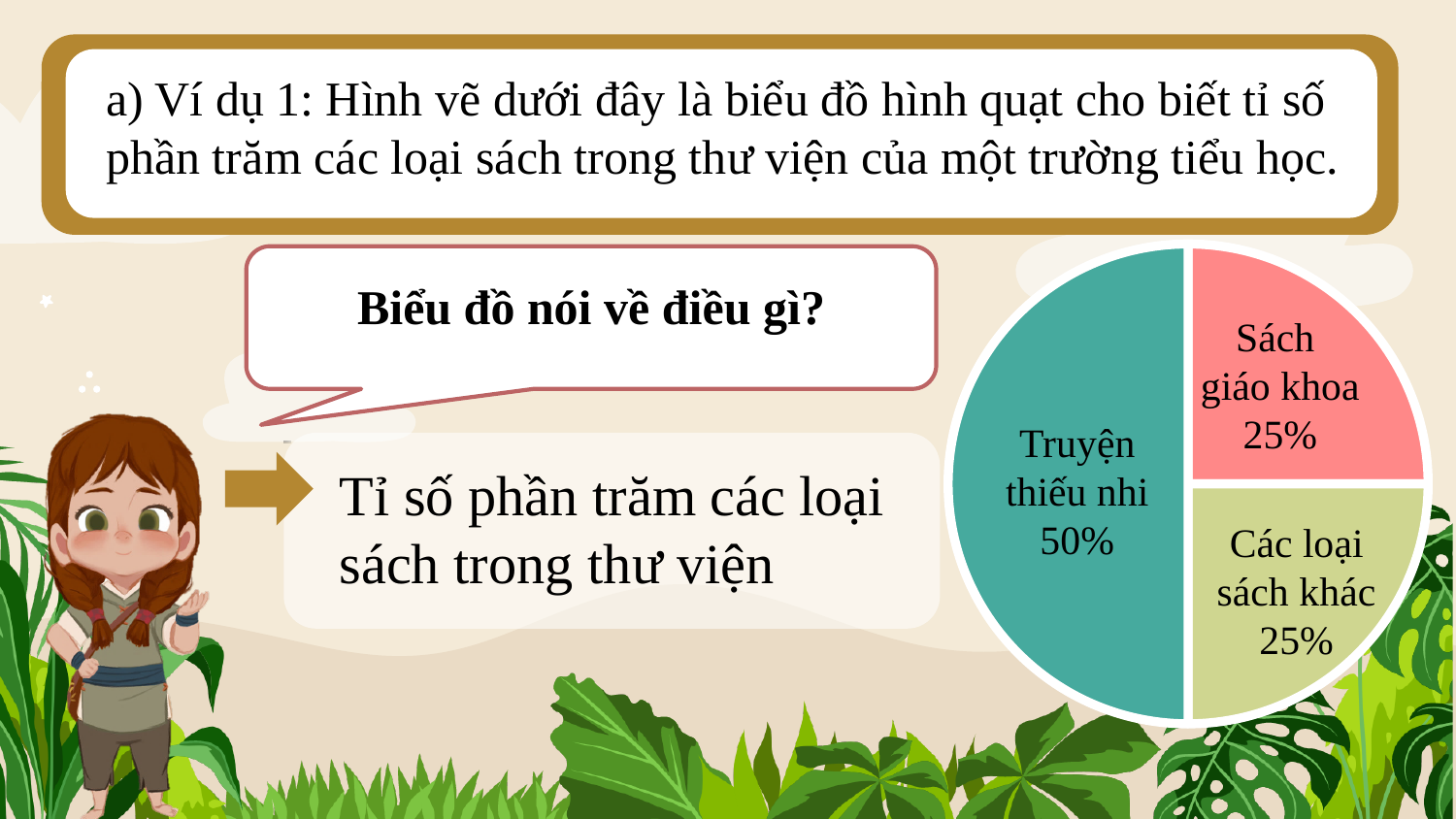
What colour is the Truyện thiếu nhi slice of the pie chart? teal How many slices does the pie chart have? 3 What colour is the Sách giáo khoa slice of the pie chart? pink What percentage of the pie chart is Các loại sách khác? 25% Which category has the largest share of the pie chart? Truyện thiếu nhi What kind of chart is shown on the slide? pie chart What is the combined share of Sách giáo khoa and Các loại sách khác? 50% What percentage of the pie chart is Truyện thiếu nhi? 50% Which is larger: the share for Truyện thiếu nhi or the share for Các loại sách khác? Truyện thiếu nhi What percentage of the pie chart is Sách giáo khoa? 25% What is the difference between the share for Truyện thiếu nhi and the share for Sách giáo khoa? 25%